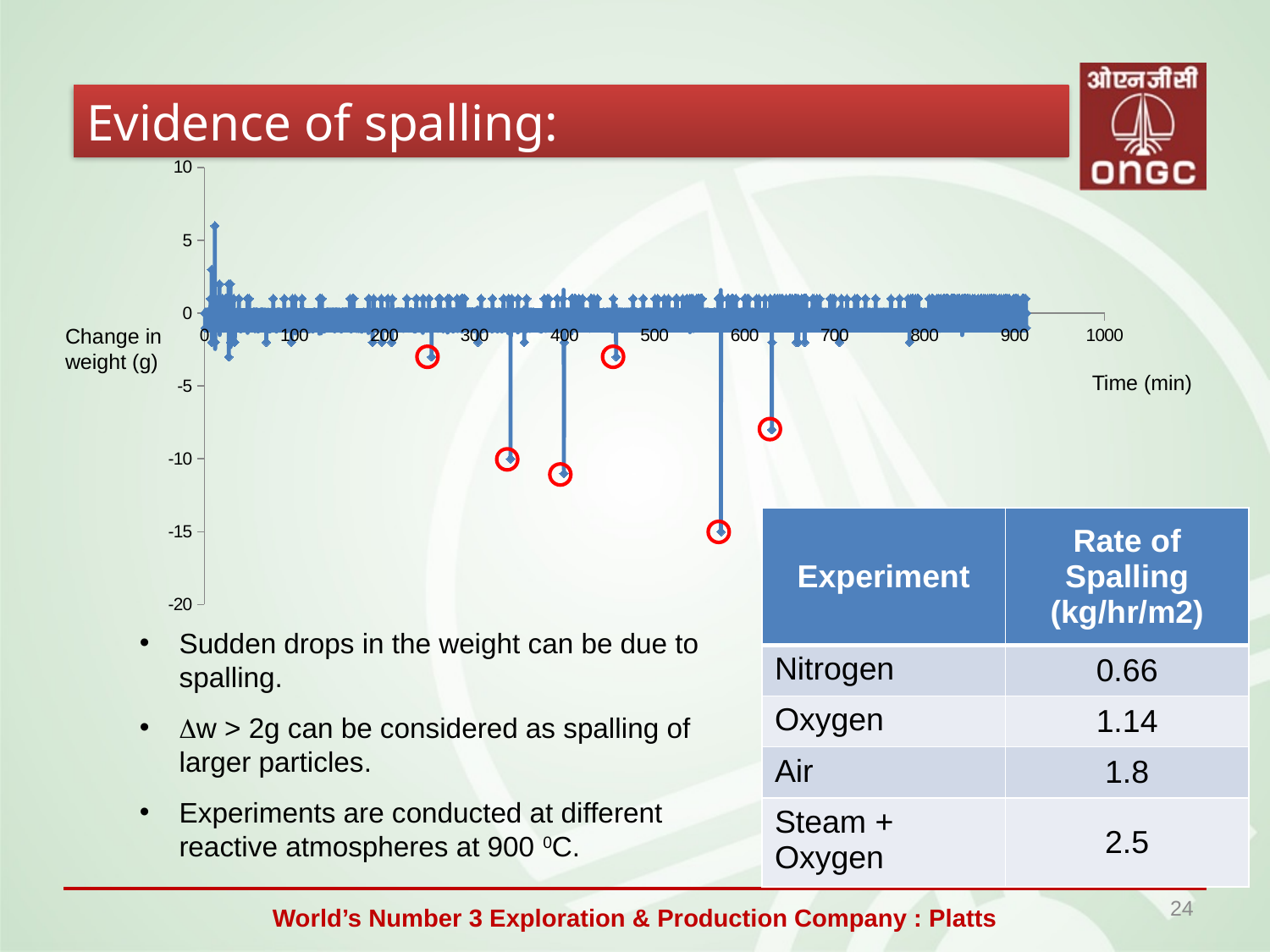
Which is deeper: the drop circled near 350 min or the drop circled near 650 min? the drop near 350 min Is the deepest drop on the chart (near 600 min) greater or less than -10 g? less How many sudden drops are marked with red circles on the chart? 6 What is the label of the vertical axis of the chart? Change in weight (g) What is the lowest value shown on the vertical axis of the chart? -20 Apart from the sudden drops, does the change in weight show a rising trend, a falling trend, or stay near zero over time? stays near zero What kind of chart is shown on the slide? line chart Does the deepest drop on the chart occur before or after 500 min? after Is the drop circled near 650 min greater or less than -5 g? less What is the label of the horizontal axis of the chart? Time (min) Is the highest value on the chart, at the very start of the experiment, greater or less than 5 g? greater